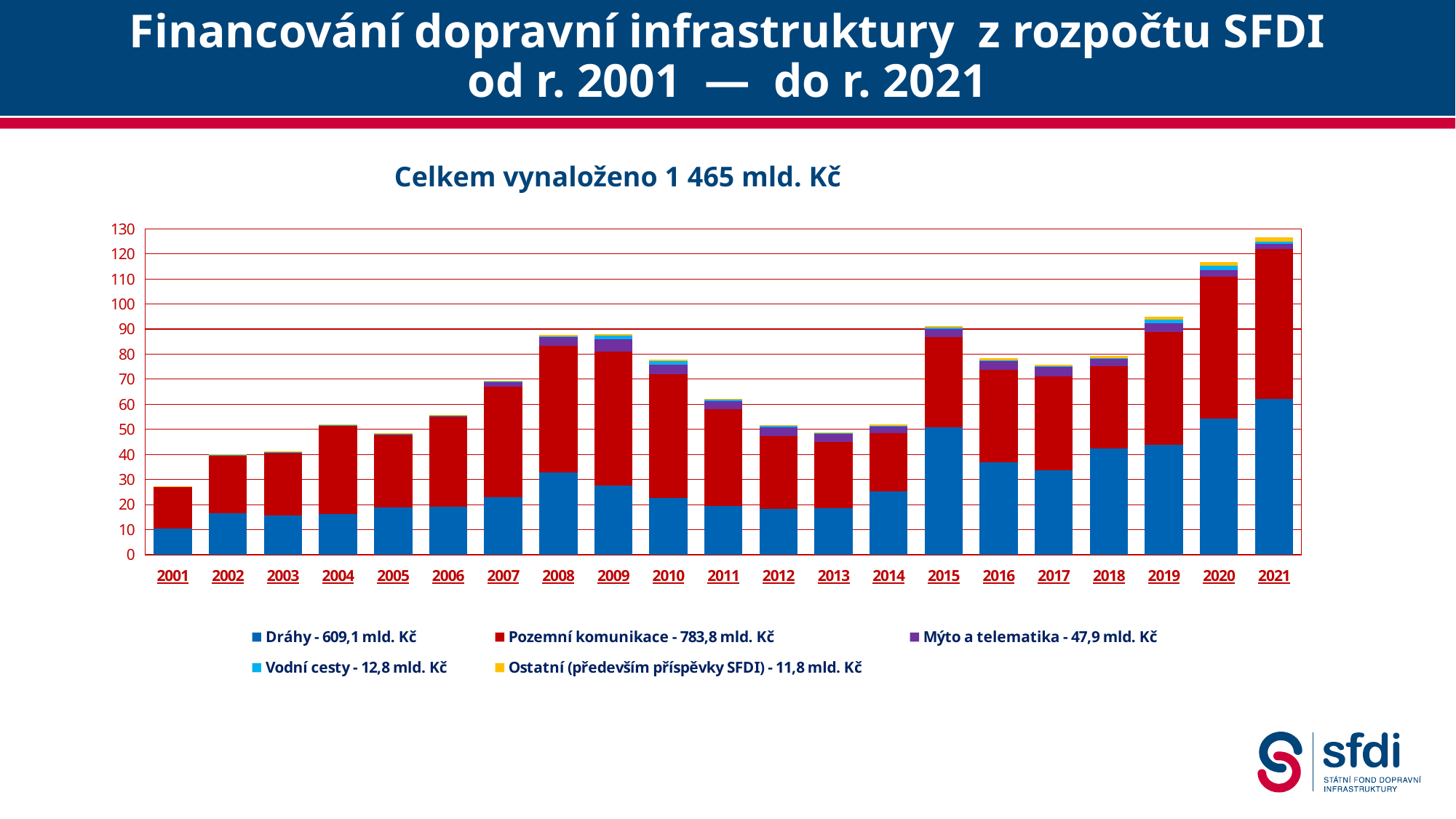
Which year has the highest total bar? 2021 How many series does the chart legend list? 5 What kind of chart is shown on the slide? stacked bar chart Is the total value for 2020 greater or less than 110? greater Which year has the lowest total bar? 2001 What total amount is stated in the chart title above the chart? 1 465 mld. Kč Is the total value for 2021 greater or less than 120? greater How many years are shown on the x axis of the chart? 21 Is the total value for 2001 greater or less than 30? less Which year has the larger total bar, 2019 or 2020? 2020 According to the legend, what is the total for Pozemní komunikace? 783,8 mld. Kč